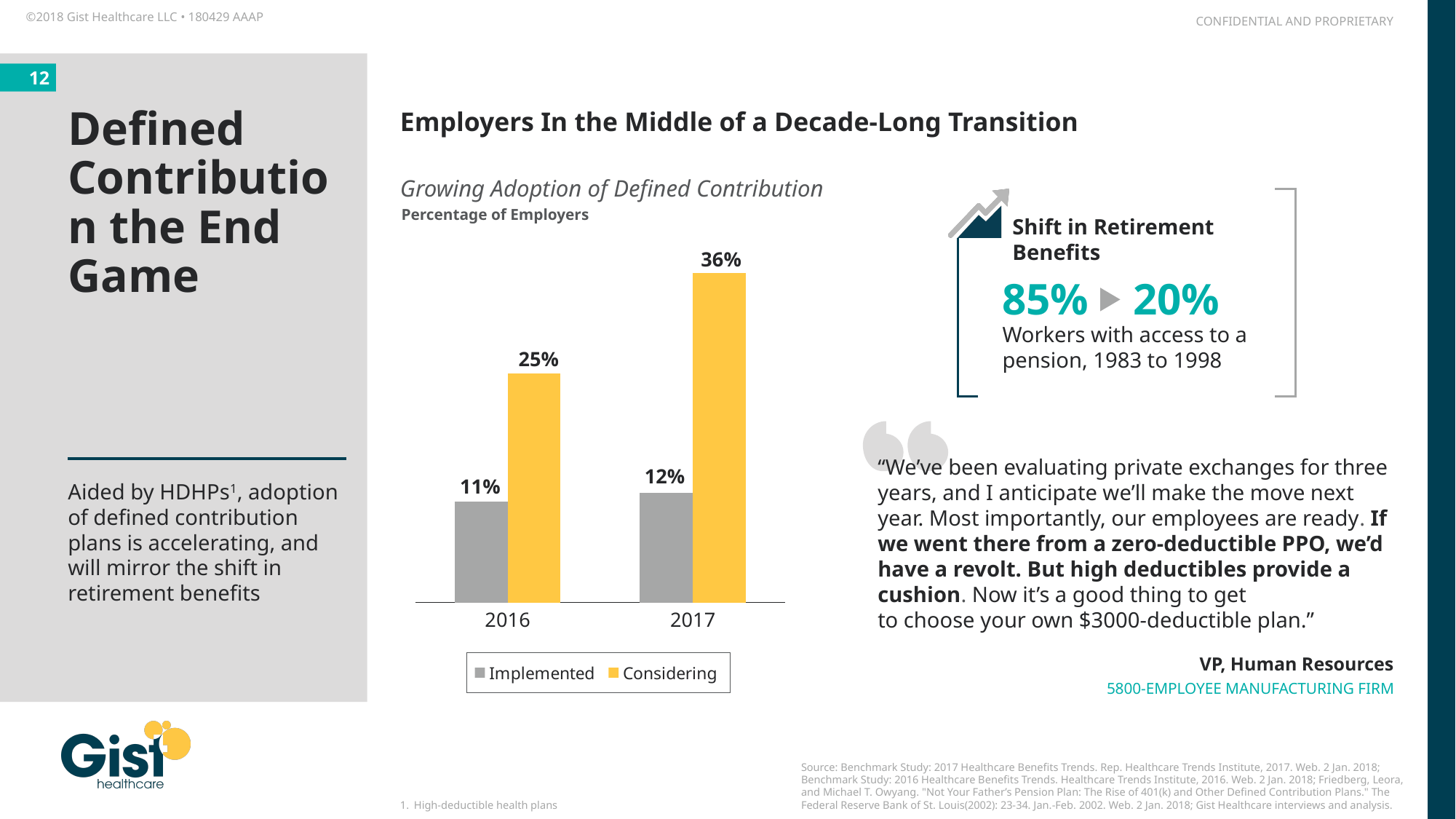
What is the difference between the Considering values for 2017 and 2016? 11% Which year has the highest Considering value? 2017 What kind of chart is shown? Bar chart What percentage of employers were considering defined contribution in 2017? 36% What is the difference between Considering and Implemented in 2017? 24% Does the Implemented value rise or fall from 2016 to 2017? Rise What is the value for Implemented in 2017? 12% What is the value for Considering in 2016? 25% Which is larger: Implemented in 2017 or Considering in 2016? Considering in 2016 Which series has the lowest value in 2016? Implemented What percentage of employers had implemented defined contribution in 2016? 11% How many series does the legend list? 2